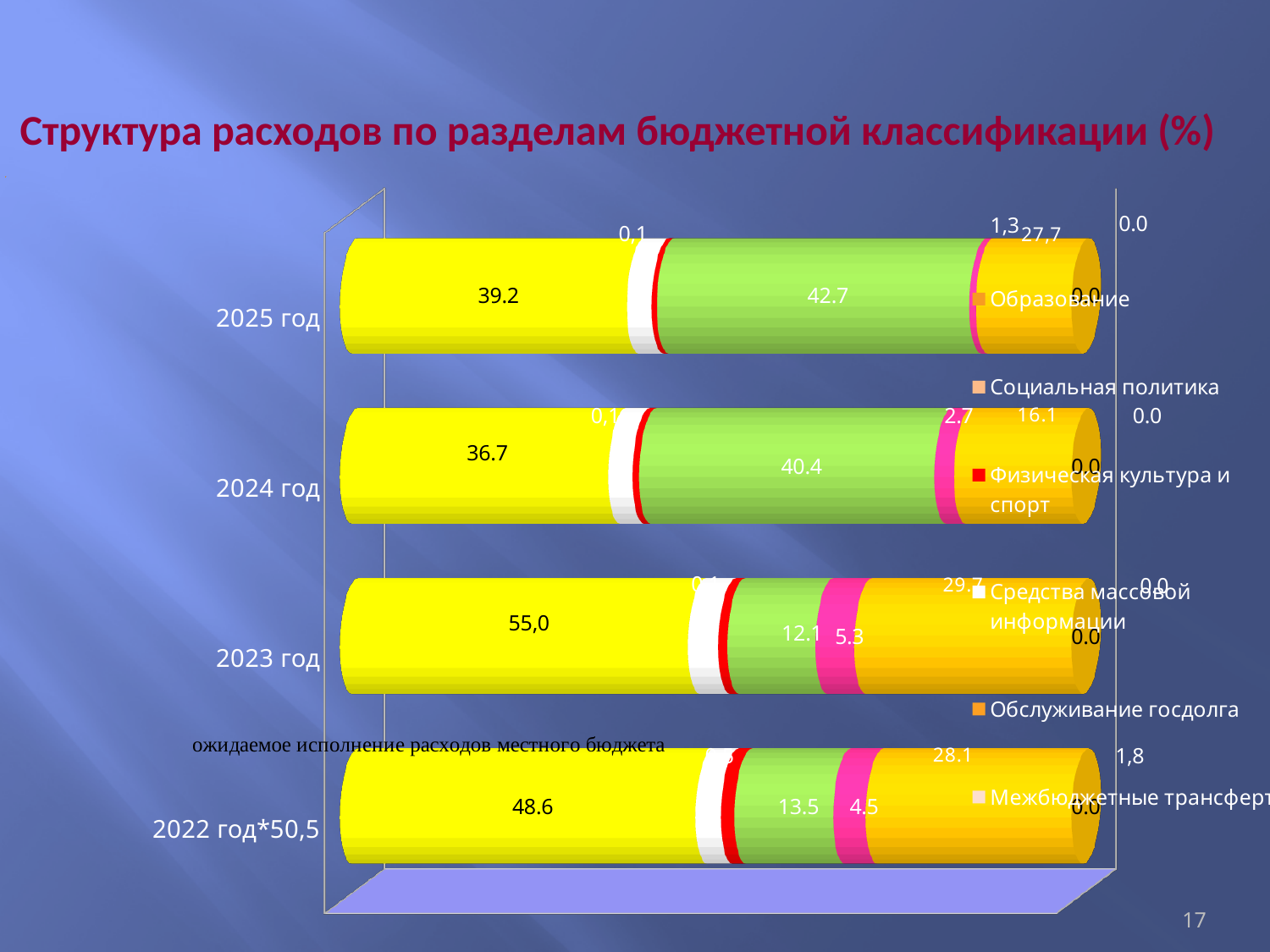
What is the value of the orange segment for 2022 год*? 28.1 What is the value of the green segment for 2024 год? 40.4 How many years (categories) are plotted on the chart? 4 What is the difference between the yellow segment for 2025 год and the yellow segment for 2024 год? 2.5 What is the value of the yellow segment for 2023 год? 55,0 In which year is the green segment the smallest? 2023 год What is the title of the chart? Структура расходов по разделам бюджетной классификации (%) What is the value of the pink segment for 2024 год? 2.7 Which is larger: the green segment for 2025 год or the green segment for 2024 год? 2025 год In which year is the yellow segment the largest? 2023 год What kind of chart is shown on the slide? stacked bar chart What is the value of the yellow segment for 2025 год? 39.2